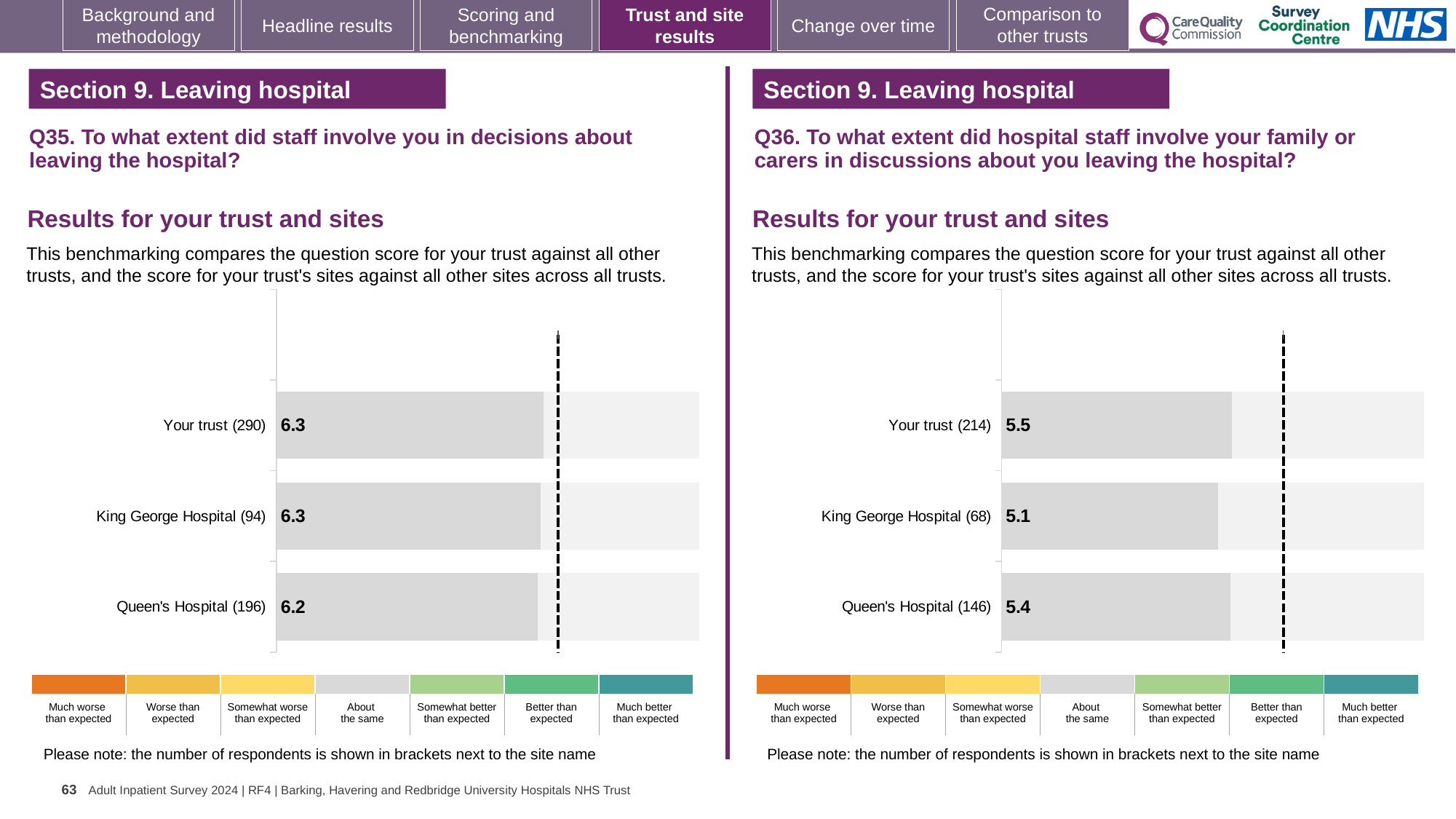
In the Q35 chart on the left, which site or trust has the lowest score? Queen's Hospital In the Q36 chart on the right, what is the difference between the scores for Your trust and King George Hospital? 0.4 In the Q35 chart on the left, what is the score for Queen's Hospital? 6.2 In the Q36 chart on the right, which has the larger score, Queen's Hospital or King George Hospital? Queen's Hospital What kind of chart is used for the Q36 results on the right? Bar chart How many bars are plotted in the Q35 chart on the left? 3 In the Q36 chart on the right, which site or trust has the lowest score? King George Hospital In the Q36 chart on the right, what is the score for Your trust? 5.5 In the Q35 chart on the left, what is the score for Your trust? 6.3 In the Q36 chart on the right, how many respondents are shown in brackets for Queen's Hospital? 146 In the Q36 chart on the right, which site or trust has the highest score? Your trust In the Q36 chart on the right, what is the score for King George Hospital? 5.1